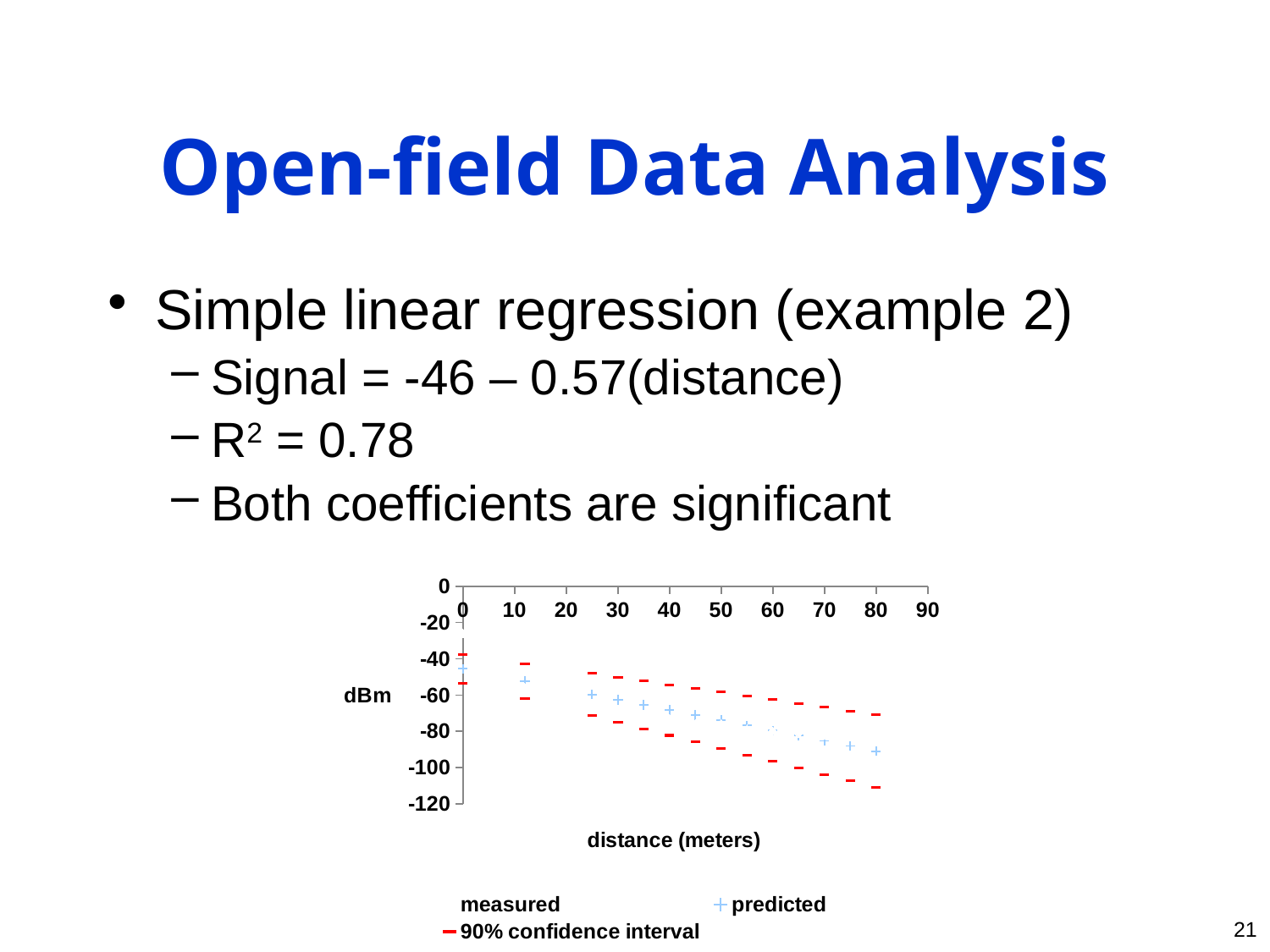
Is the predicted value at a distance of 80 meters greater or less than -100 dBm? greater What is the largest distance value shown on the x axis of the chart? 90 What kind of chart is shown on the slide? scatter chart Is the predicted value at a distance of 0 meters greater or less than -60 dBm? greater Which is larger, the predicted value at 0 meters or the predicted value at 80 meters? the predicted value at 0 meters Do the predicted values rise or fall as distance increases along the x axis? fall What is the label on the y axis of the chart? dBm How many series does the chart legend list? 3 What is the title of the x axis of the chart? distance (meters) Is the predicted value at a distance of 80 meters greater or less than -60 dBm? less